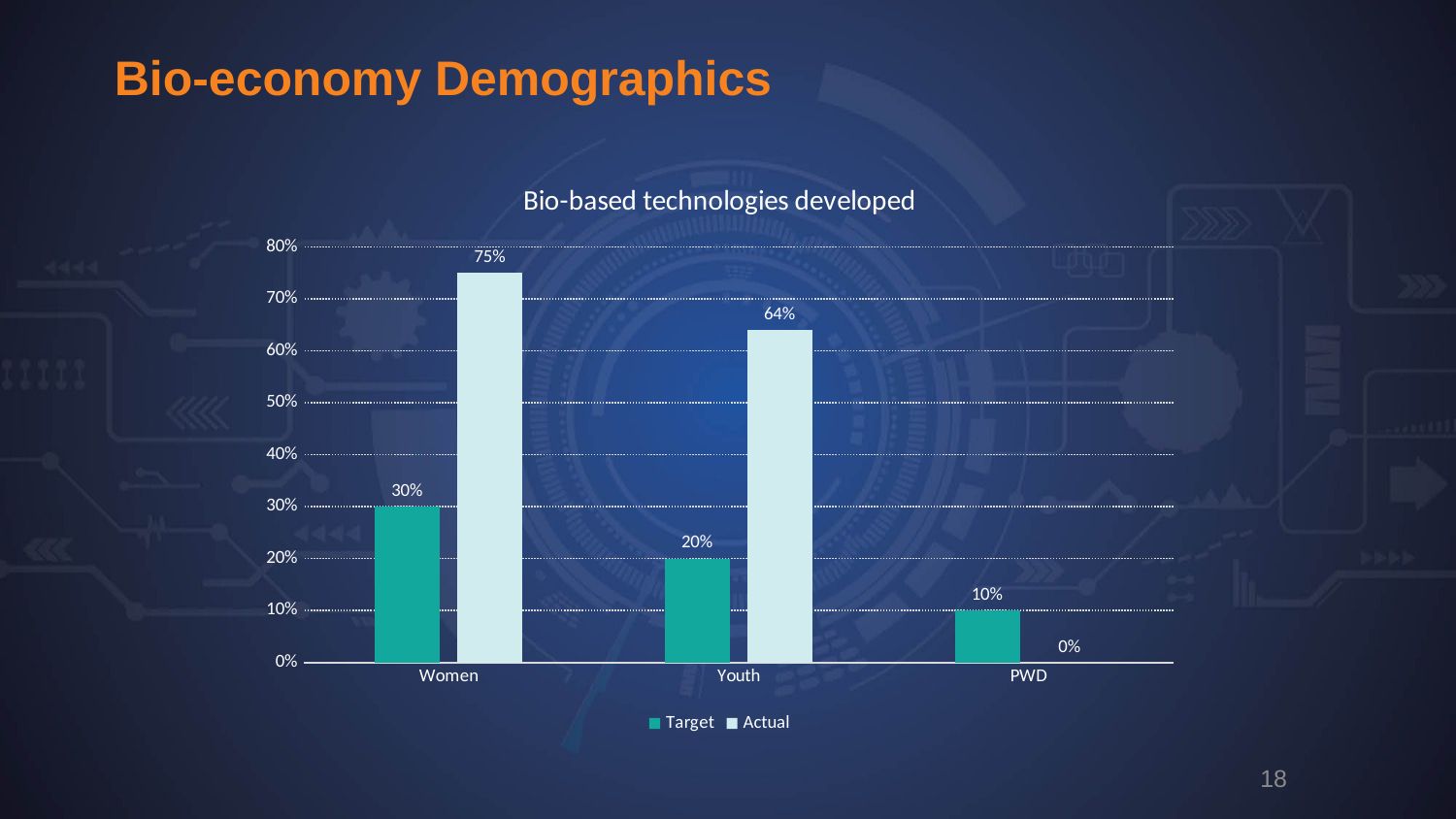
What is the Target value for Youth? 20% What kind of chart is shown on the slide? Bar chart What is the difference between the Actual and Target values for Women? 45% Which category has the lowest Target value? PWD How many series does the legend list? 2 How many categories are shown on the x axis? 3 What is the Actual value for PWD? 0% What is the Target value for PWD? 10% What is the Actual value for Women? 75% Which category has the highest Actual value? Women What is the title of the chart? Bio-based technologies developed Which is larger for Youth, the Target or the Actual value? Actual